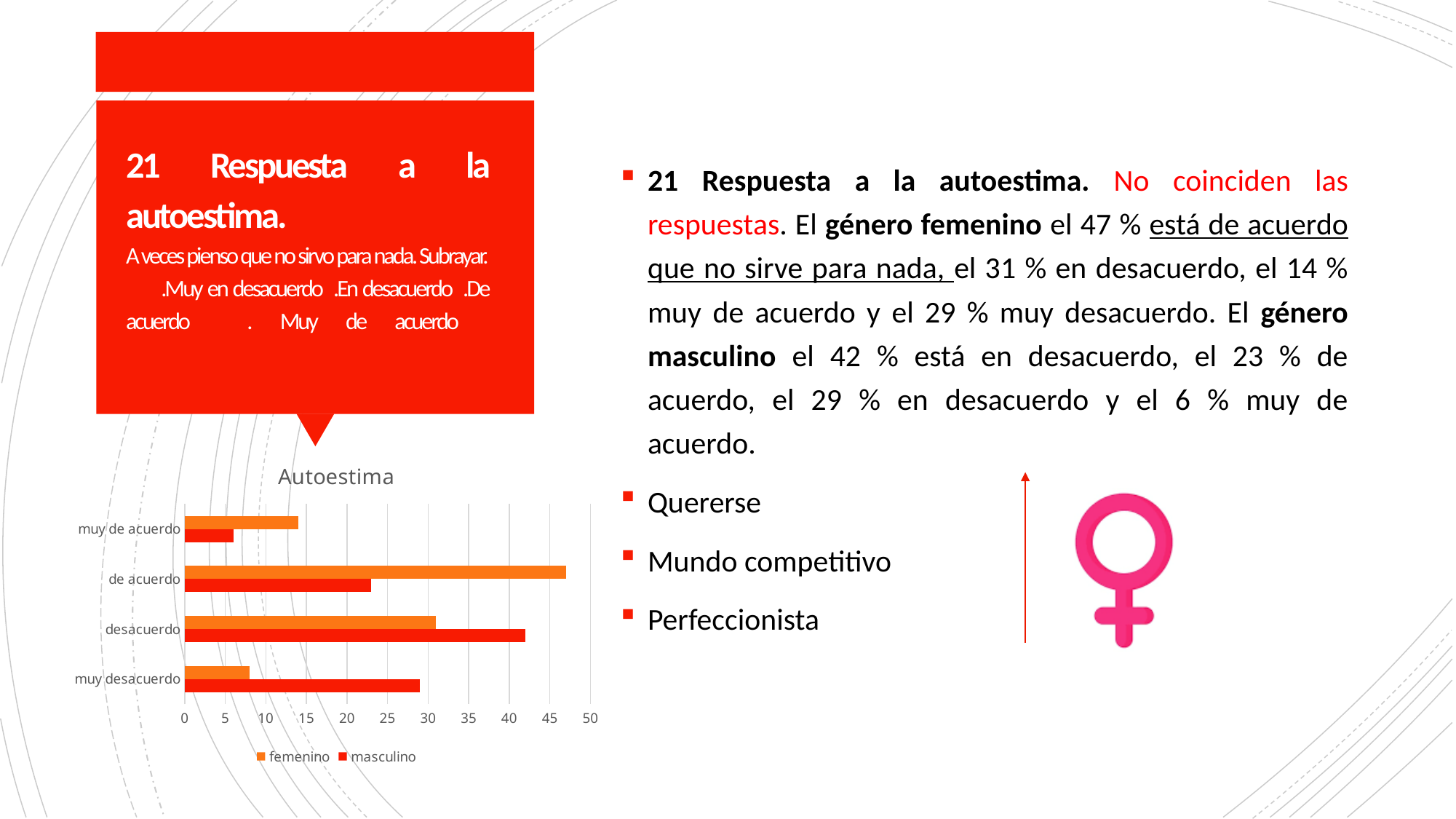
For "desacuerdo", which series has the larger value, femenino or masculino? masculino Is the masculino value for "muy de acuerdo" greater or less than 10? less How many categories are shown on the y axis of the Autoestima chart? 4 Is the femenino value for "de acuerdo" greater or less than 45? greater Which category has the highest value for the femenino series? de acuerdo Is the masculino value for "muy desacuerdo" greater or less than 25? greater How many series does the legend of the Autoestima chart list? 2 What is the title of the chart on the slide? Autoestima Which category has the highest value for the masculino series? desacuerdo For "muy desacuerdo", which series has the larger value, femenino or masculino? masculino Which category has the lowest value for the masculino series? muy de acuerdo What kind of chart is shown under the title "Autoestima"? bar chart